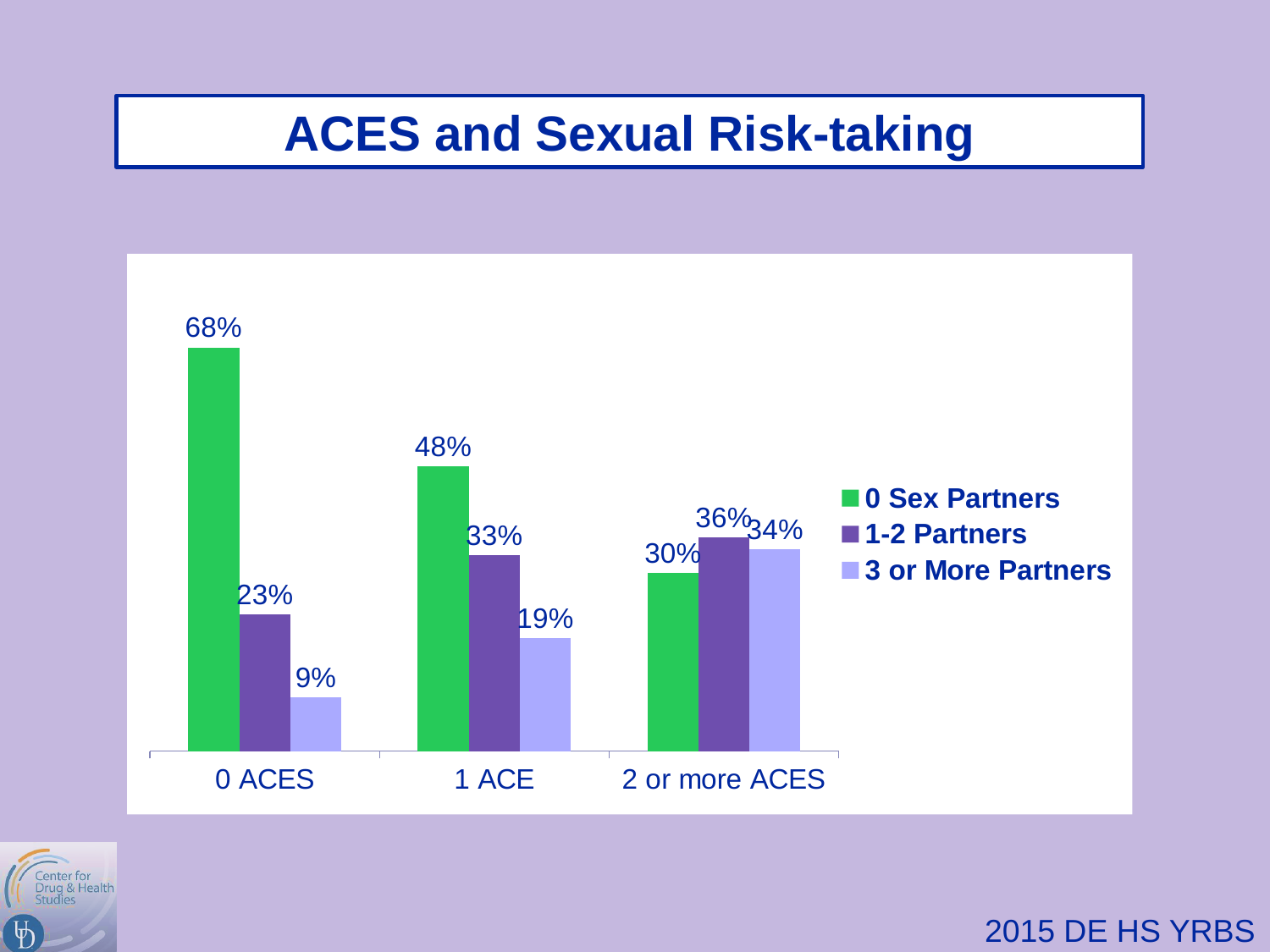
Which category has the lowest value for 3 or More Partners? 0 ACES What is the value for 3 or More Partners in the 1 ACE category? 19% Which is larger: 1-2 Partners for 1 ACE or 3 or More Partners for 2 or more ACES? 3 or More Partners for 2 or more ACES What is the value for 0 Sex Partners in the 0 ACES category? 68% How many series does the legend list? 3 Do the values for 0 Sex Partners rise or fall from 0 ACES to 2 or more ACES? fall What is the title of the slide? ACES and Sexual Risk-taking What kind of chart is shown on the slide? bar chart What is the value for 1-2 Partners in the 2 or more ACES category? 36% How many categories are shown on the x axis? 3 Which category has the highest value for 0 Sex Partners? 0 ACES What is the difference between the 0 Sex Partners values for 0 ACES and 1 ACE? 20%